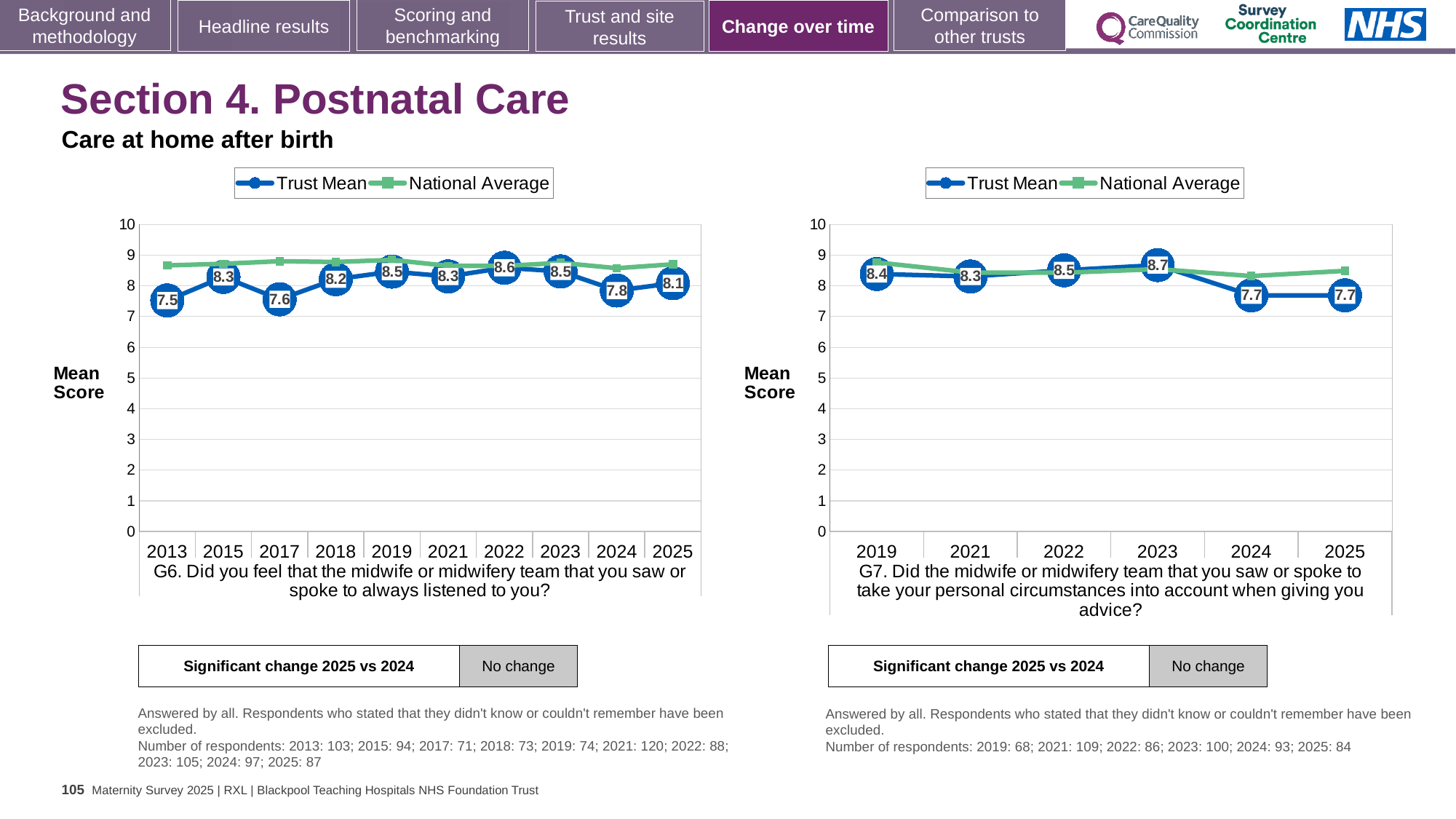
In the G6 chart (left), which year has the highest Trust Mean? 2022 What kind of chart is the G6 chart (left)? line chart In the G7 chart (right), how many series does the legend list? 2 In the G6 chart (left), what is the difference between the Trust Mean for 2022 and the Trust Mean for 2013? 1.1 In the G6 chart (left), what is the Trust Mean for 2013? 7.5 In the G7 chart (right), what is the Trust Mean for 2024? 7.7 In the G6 chart (left), which year has the lowest Trust Mean? 2013 In the G7 chart (right), what is the Trust Mean for 2023? 8.7 In the G6 chart (left), how many years are plotted on the x axis? 10 In the G7 chart (right), which year has the highest Trust Mean? 2023 In the G6 chart (left), what is the Trust Mean for 2025? 8.1 In the G7 chart (right), is the Trust Mean for 2021 larger or smaller than the Trust Mean for 2025? larger